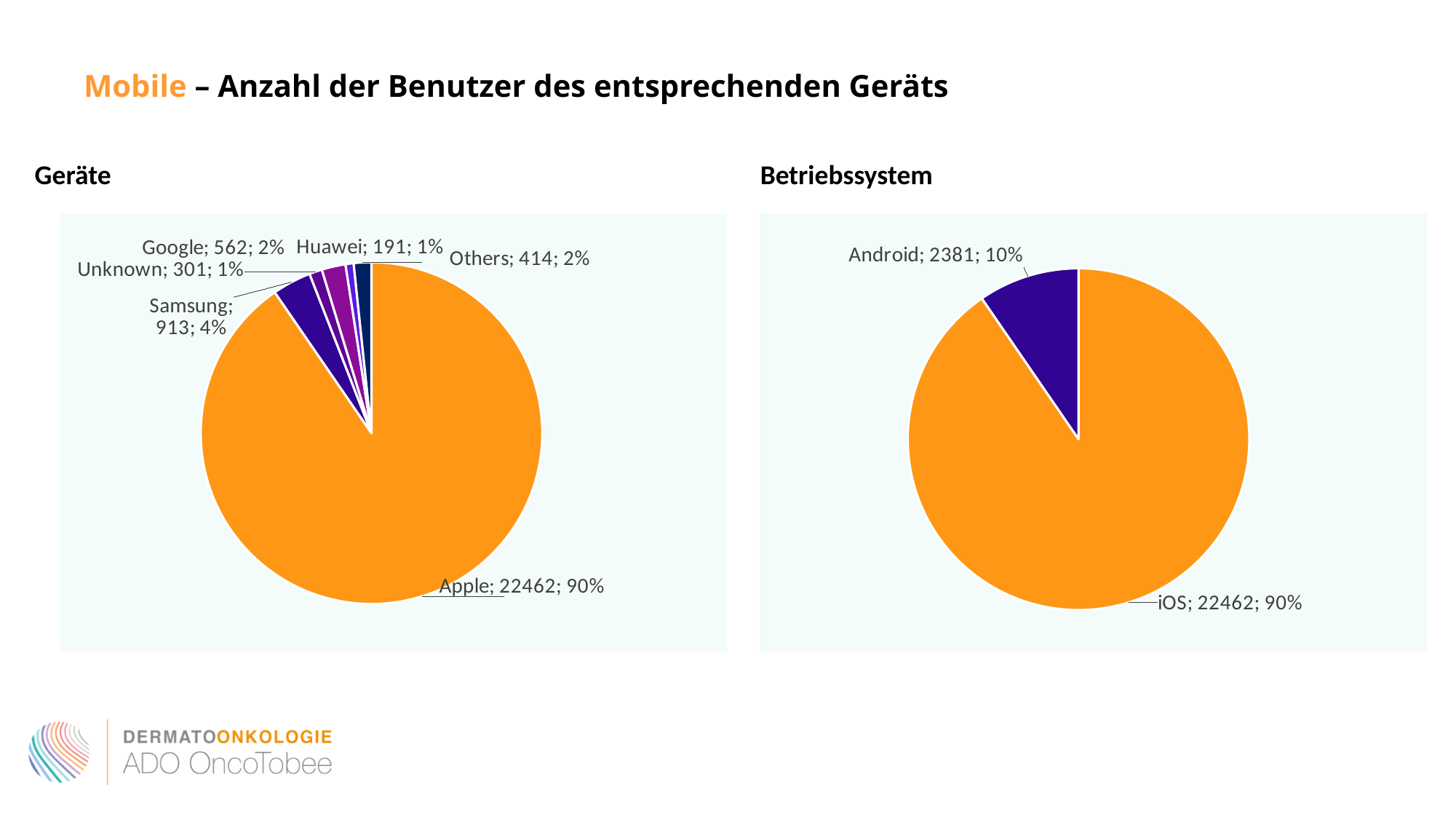
In the Geräte chart, which device has the largest number of users? Apple How many slices does the Geräte pie chart have? 6 In the Betriebssystem chart, what share of the pie does iOS have? 90% In the Geräte chart, what share of the pie does Google have? 2% What type of chart is the Betriebssystem chart? Pie chart In the Geräte chart, which has more users, Samsung or Others? Samsung In the Betriebssystem chart, what is the difference in users between iOS and Android? 20081 In the Geräte chart, what is the difference in users between Google and Unknown? 261 In the Geräte chart, which device has the smallest number of users? Huawei In the Geräte chart, how many users are shown for Apple? 22462 In the Betriebssystem chart, how many users are shown for Android? 2381 In the Geräte chart, how many users are shown for Samsung? 913